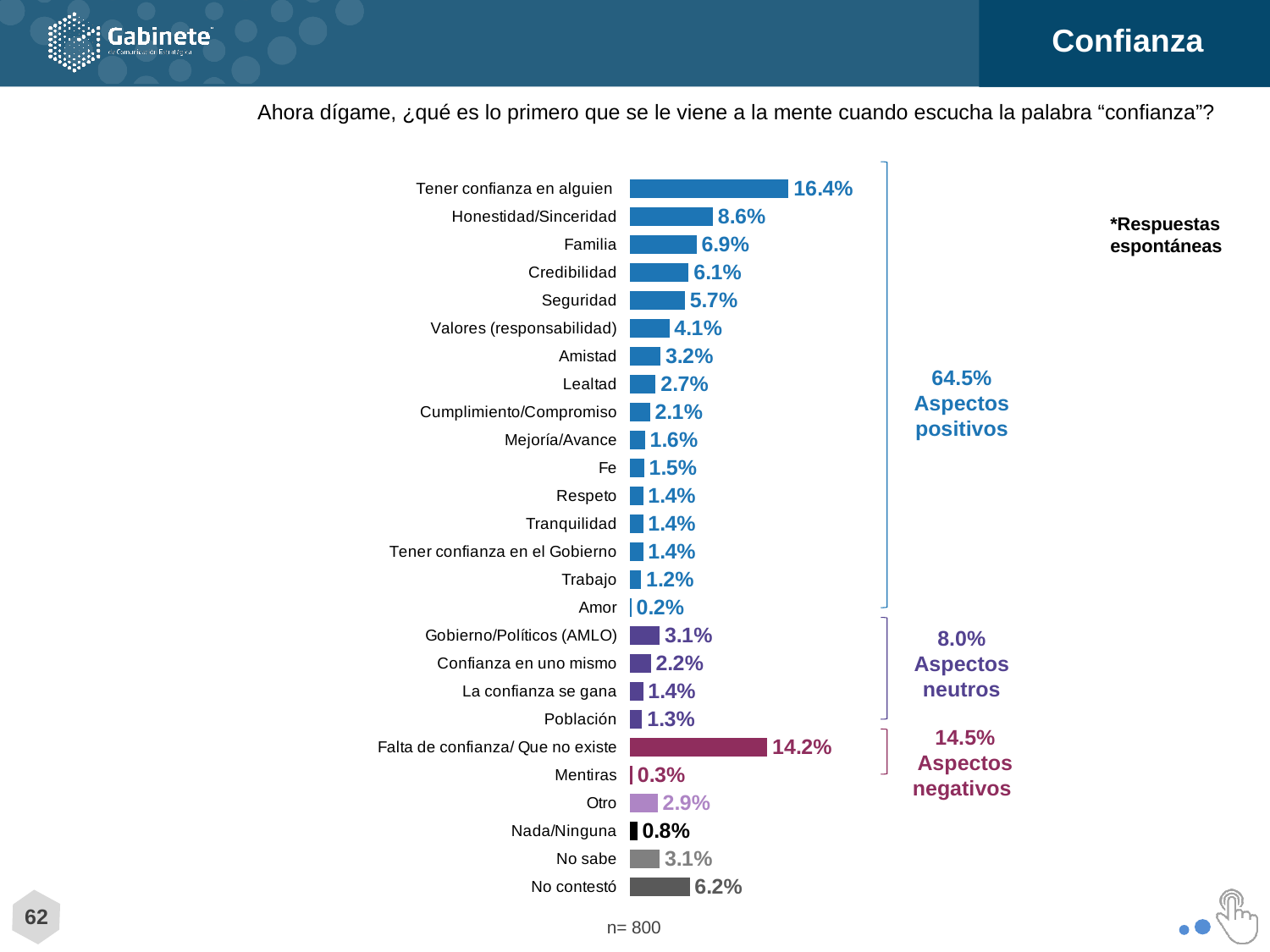
What is the value for "Tener confianza en alguien"? 16.4% What is the value for "Familia"? 6.9% What kind of chart is shown on the slide? Bar chart What is the value for "Falta de confianza/ Que no existe"? 14.2% Which category has the highest value? Tener confianza en alguien What percentage is given for "Aspectos positivos"? 64.5% How many categories are shown in the chart? 26 What is the difference between "Tener confianza en alguien" and "Honestidad/Sinceridad"? 7.8% What is the value for "No contestó"? 6.2% Which is larger, "Seguridad" or "Credibilidad"? Credibilidad What is the sample size (n) shown on the slide? 800 Which category has the lowest value? Amor